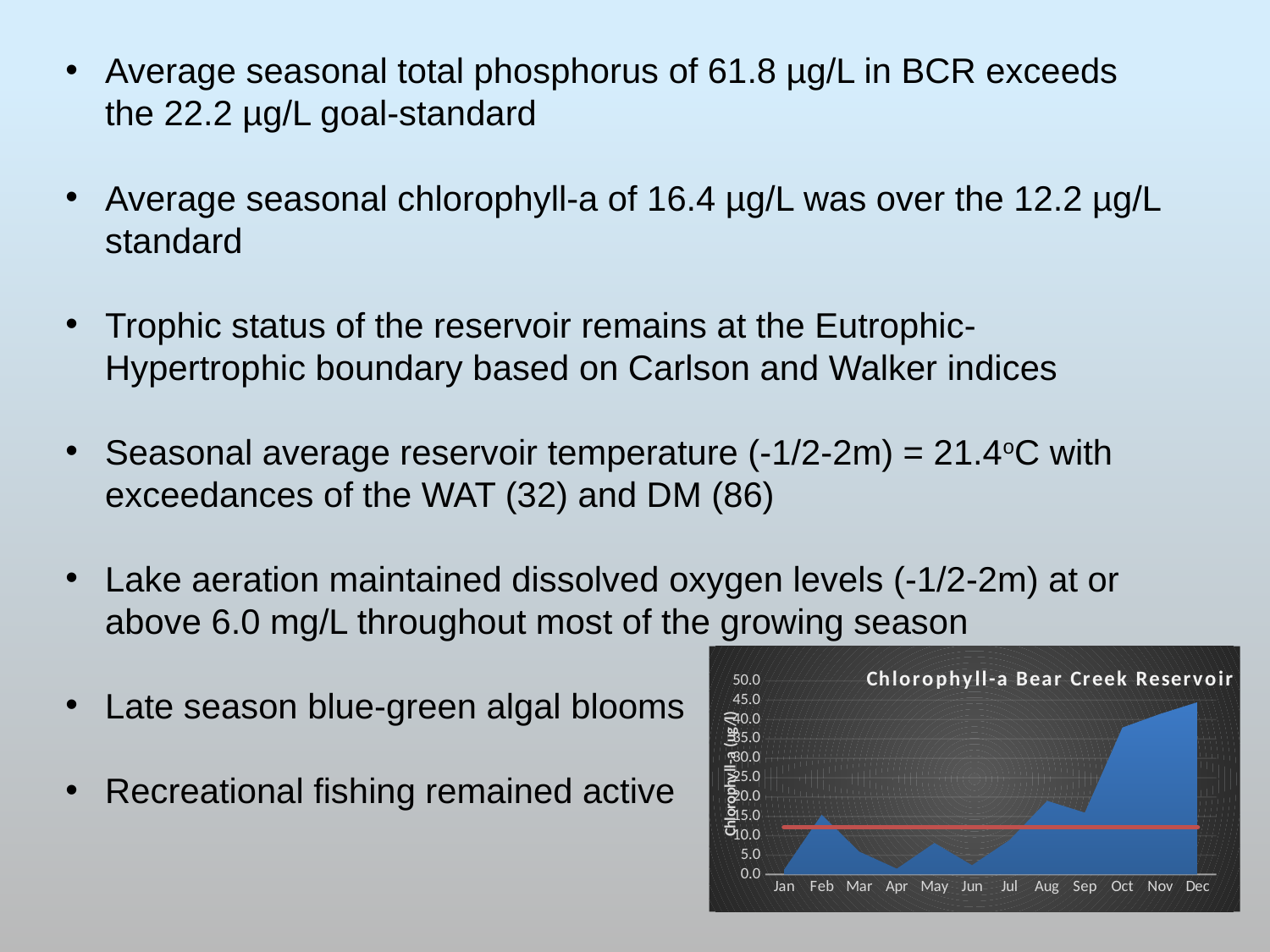
Is the chlorophyll-a value for Apr greater or less than 5.0? less What is the title of the chart on the slide? Chlorophyll-a Bear Creek Reservoir How many months are shown on the x axis of the Chlorophyll-a Bear Creek Reservoir chart? 12 Is the chlorophyll-a value for Sep greater or less than 10.0? greater Which month has the higher chlorophyll-a value, Oct or Feb? Oct What kind of chart is the Chlorophyll-a Bear Creek Reservoir chart? area and line chart In which month does chlorophyll-a reach its highest value in the Chlorophyll-a Bear Creek Reservoir chart? Dec Is the chlorophyll-a value for Oct greater or less than 30.0? greater What is the highest tick value shown on the y axis of the Chlorophyll-a Bear Creek Reservoir chart? 50.0 Does chlorophyll-a rise or fall from Aug to Nov in the Chlorophyll-a Bear Creek Reservoir chart? rise